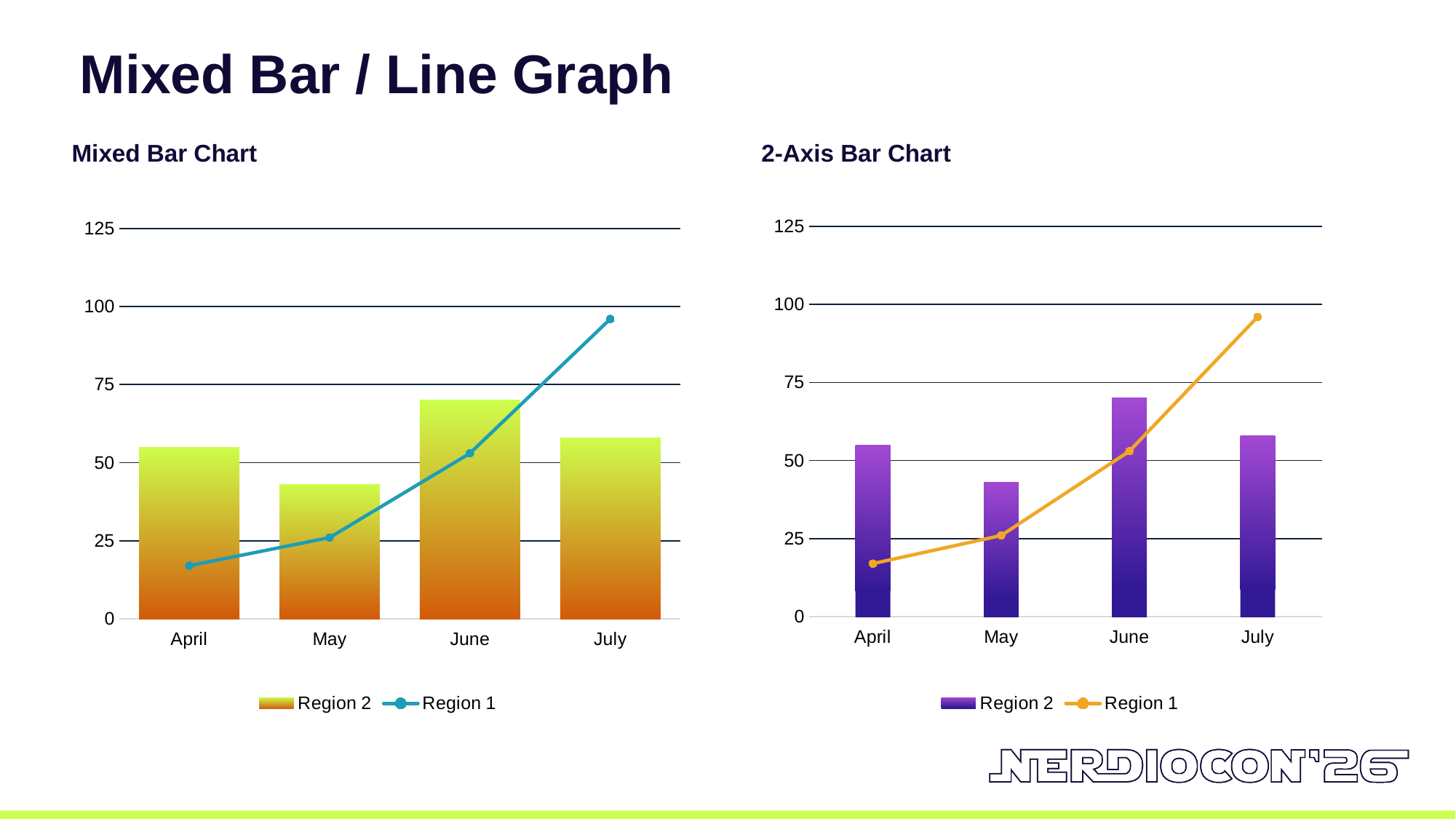
In the 2-Axis Bar Chart, what colour is the Region 1 line? Orange In the 2-Axis Bar Chart, which is larger in July: Region 1 or Region 2? Region 1 In the Mixed Bar Chart, how many series does the legend list? 2 In the Mixed Bar Chart, how many months are shown on the x axis? 4 In the 2-Axis Bar Chart, in which month is the Region 1 value highest? July In the Mixed Bar Chart, which month has the highest Region 2 bar? June In the Mixed Bar Chart, is the Region 2 value for May greater or less than 50? less In the Mixed Bar Chart, does the Region 1 line rise or fall from April to July? rise In the 2-Axis Bar Chart, which is larger in April: Region 1 or Region 2? Region 2 In the Mixed Bar Chart, is the Region 1 value for July greater or less than 75? greater In the 2-Axis Bar Chart, is the Region 1 value for April greater or less than 25? less In the Mixed Bar Chart, which month has the lowest Region 2 bar? May